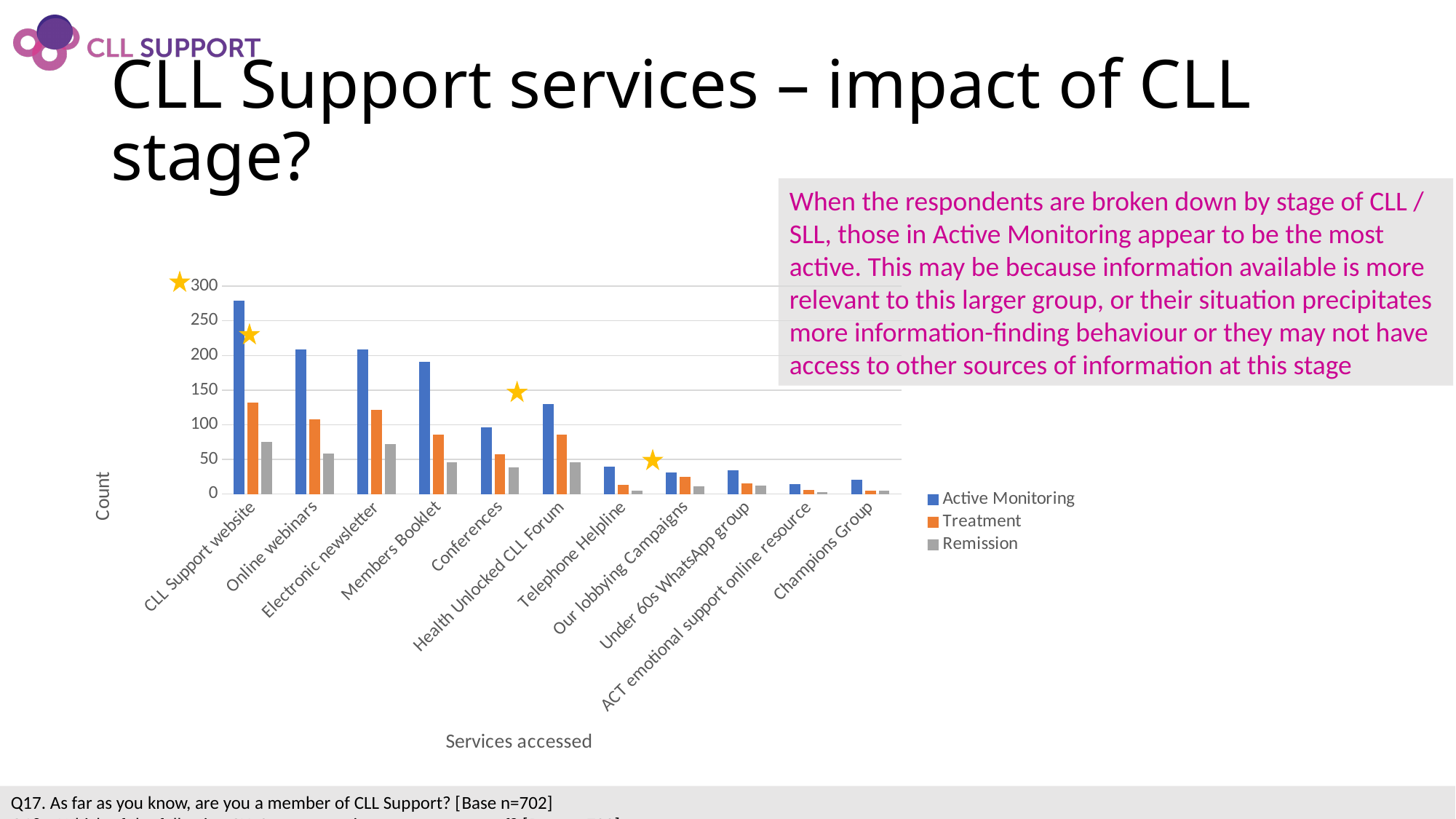
Is the Active Monitoring value for CLL Support website greater or less than 250? greater What is the label on the chart's x axis? Services accessed Which has the larger Active Monitoring count, Conferences or Health Unlocked CLL Forum? Health Unlocked CLL Forum Do the Active Monitoring values generally rise or fall moving from left to right along the x axis? Fall How many service categories are plotted along the x axis? 11 Is the Treatment value for CLL Support website greater or less than 100? greater Is the Active Monitoring value for Telephone Helpline greater or less than 50? less What kind of chart is shown on the slide? Bar chart How many series does the chart legend list? 3 Which service has the lowest Active Monitoring count? ACT emotional support online resource Which service has the highest Active Monitoring count? CLL Support website